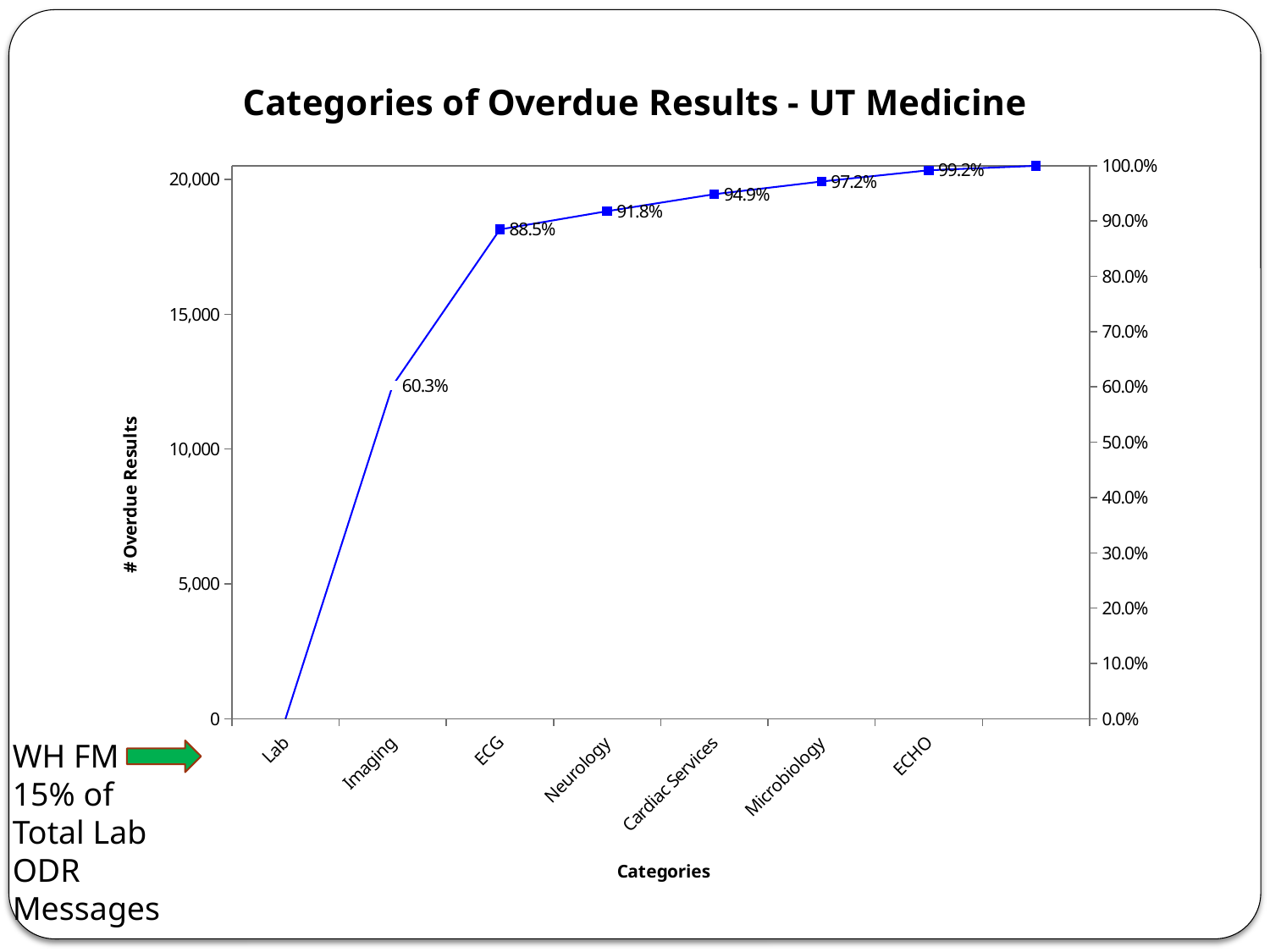
What cumulative percentage is labelled at Neurology? 91.8% What is the difference between the labelled values at ECHO and Microbiology? 2.0 percentage points By how many percentage points does the labelled value at ECG exceed the labelled value at Imaging? 28.2 percentage points Which has the higher labelled cumulative percentage, Neurology or Cardiac Services? Cardiac Services What cumulative percentage is labelled at Imaging? 60.3% What cumulative percentage is labelled at ECHO? 99.2% What cumulative percentage is labelled at Cardiac Services? 94.9% What cumulative percentage is labelled at ECG? 88.5% What kind of chart is shown on the slide? Line chart What is the title of the chart? Categories of Overdue Results - UT Medicine Does the plotted line rise or fall from left to right across the categories? Rises What cumulative percentage is labelled at Microbiology? 97.2%